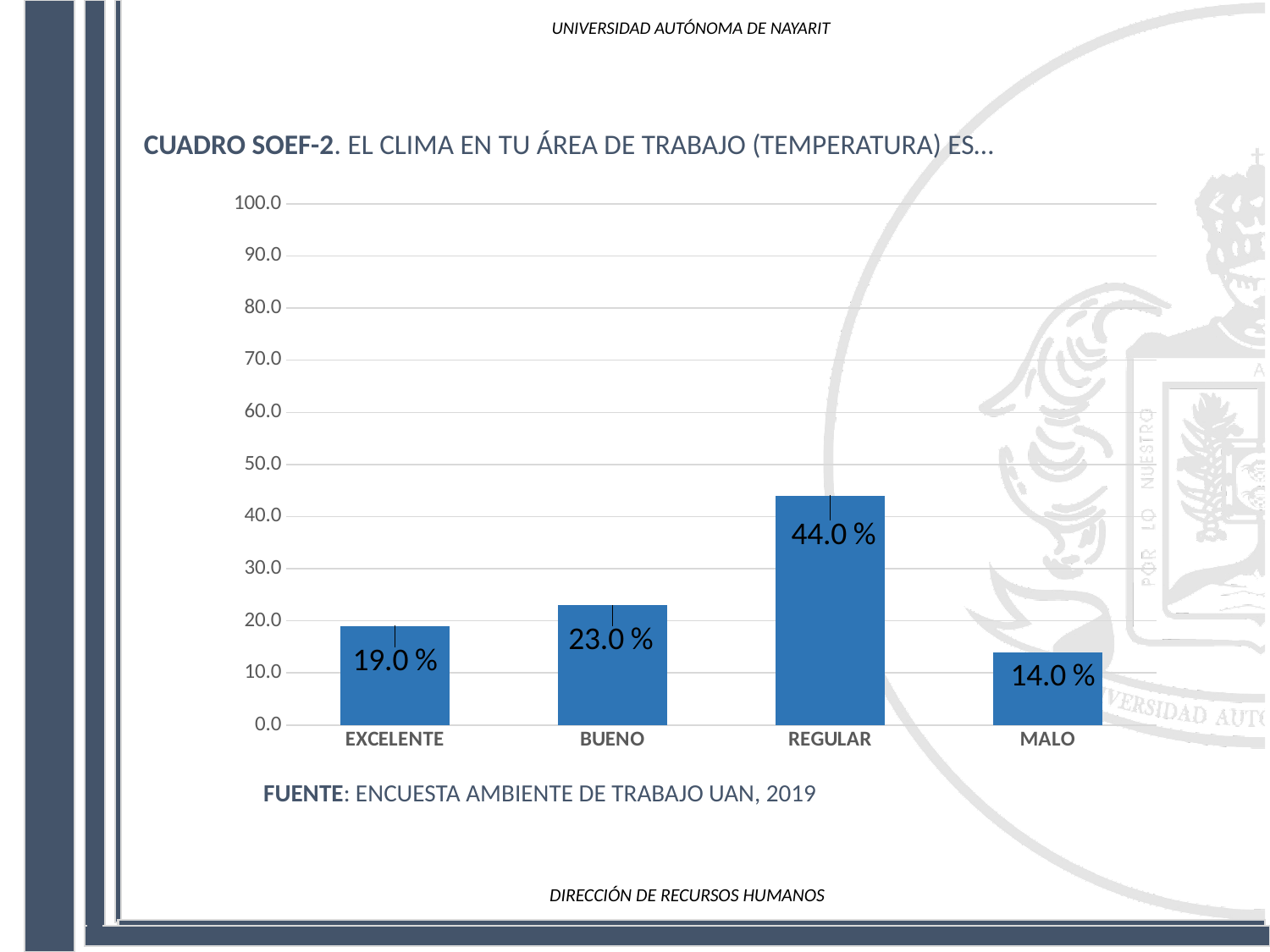
What kind of chart is shown on the slide? bar chart How many categories are shown on the x axis? 4 What source is cited below the chart? ENCUESTA AMBIENTE DE TRABAJO UAN, 2019 What is the value for EXCELENTE? 19.0 % Is the value for REGULAR greater or less than 40.0? greater Which category has the highest value? REGULAR What is the value for REGULAR? 44.0 % What is the maximum value shown on the y axis? 100.0 Which is larger, the value for BUENO or the value for EXCELENTE? BUENO What is the value for MALO? 14.0 % Which category has the lowest value? MALO What is the difference between the values for REGULAR and BUENO? 21.0 %